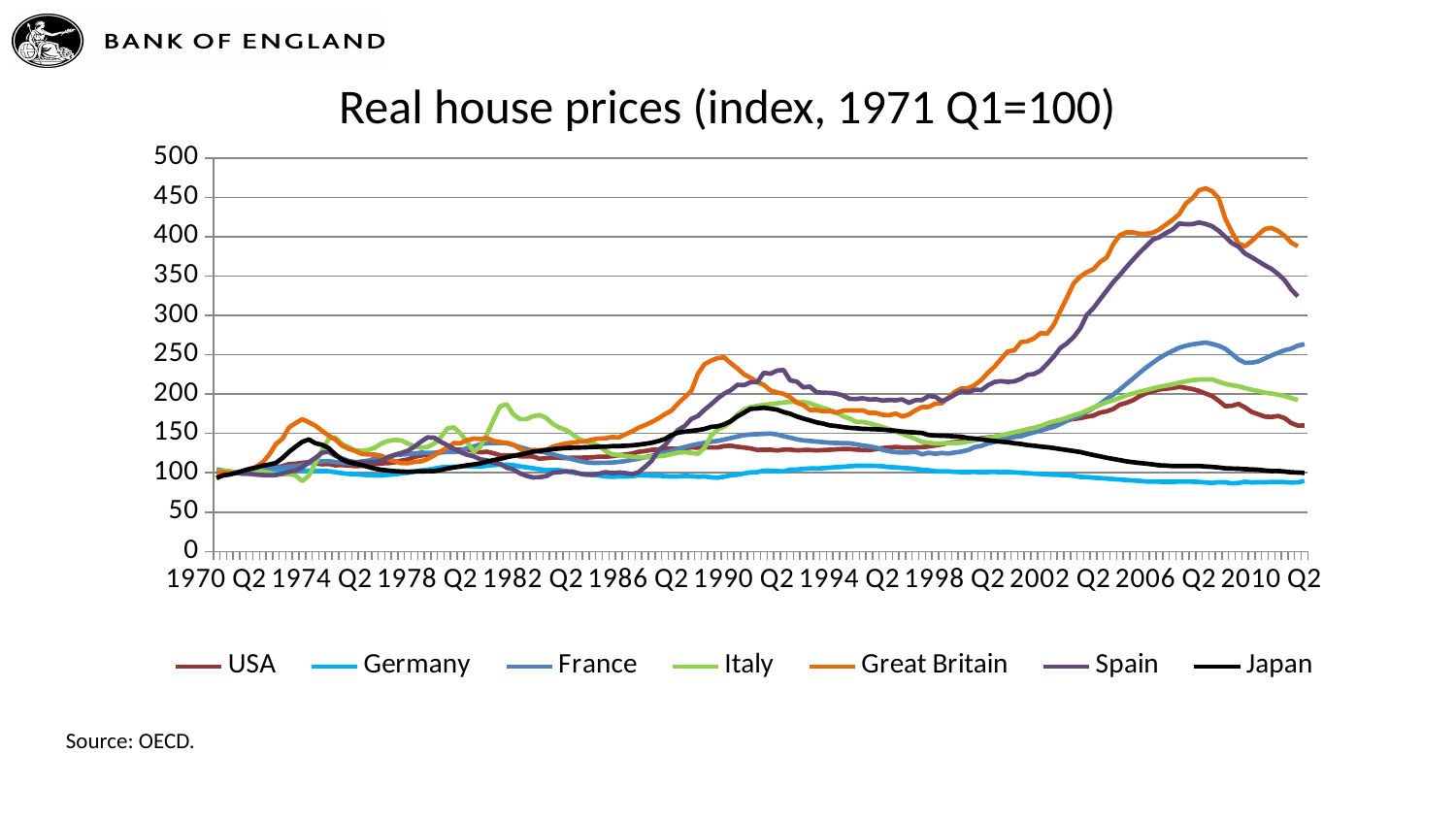
At the right-hand end of the chart, is the value for Germany greater or less than 100? less What kind of chart is shown on the slide? Line chart At the right-hand end of the chart, which series has the lowest value? Germany Which series reaches the highest value anywhere on the chart? Great Britain Around 2006 Q2, which series is higher, Spain or France? Spain At the right-hand end of the chart, which series is higher, Great Britain or Spain? Great Britain What source is cited for the chart data? OECD Is the peak value of the Spain series greater or less than 400? greater How many series does the legend list? 7 Is the peak value of the Great Britain series greater or less than 400? greater What is the title of the chart? Real house prices (index, 1971 Q1=100) Does the Japan series rise or fall between 1990 Q2 and 2010 Q2? Fall